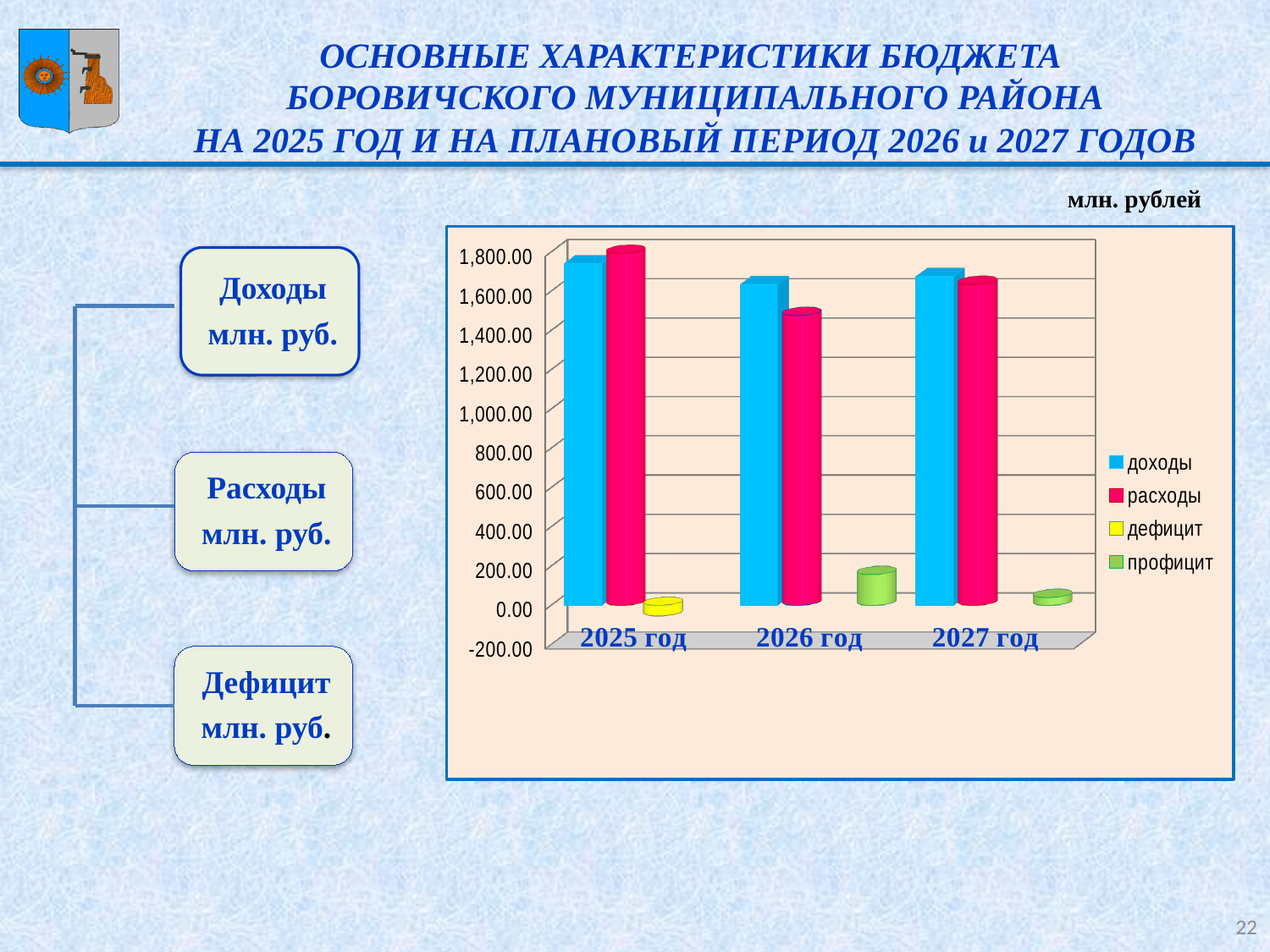
How many years (categories) are shown on the x axis of the chart? 3 What kind of chart is shown on the slide? bar chart In which year are расходы (expenditures) the lowest? 2026 год In which year are расходы (expenditures) the highest? 2025 год How many series does the chart legend list? 4 What unit of measurement is stated above the chart? млн. рублей In 2026 год, which is larger: доходы or расходы? доходы In which year does the chart show a дефицит (deficit) bar? 2025 год Is the value for расходы in 2026 год greater or less than 1,600.00? less Is the value for доходы in 2025 год greater or less than 1,600.00? greater Is the value for профицит in 2026 год greater or less than 200.00? less